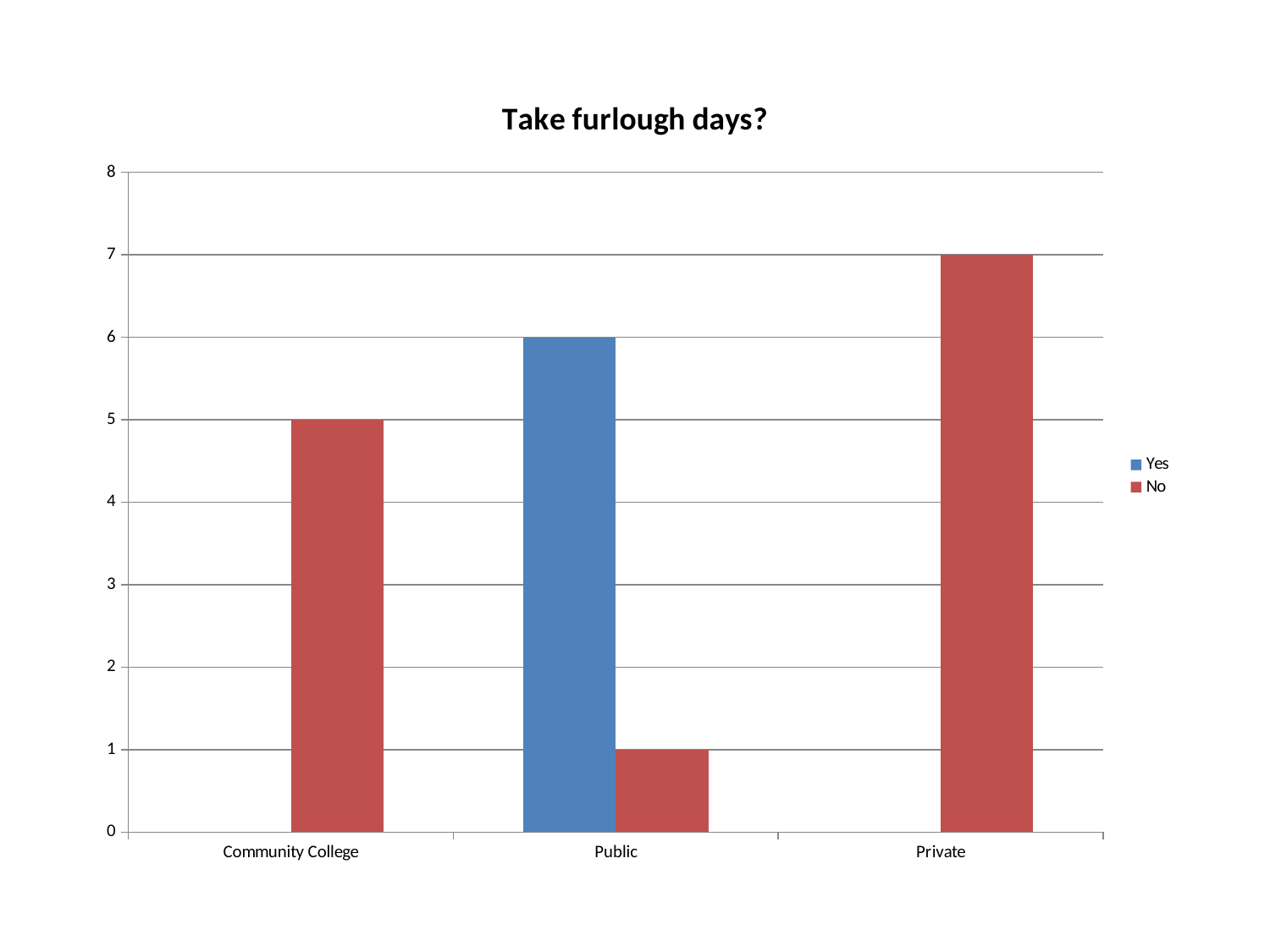
How many series does the legend list? 2 How many categories are shown on the x axis? 3 What is the value of Yes for Public? 6 What is the difference between the No value for Private and the No value for Community College? 2 What is the value of No for Private? 7 What kind of chart is shown on the slide? bar chart What is the title of the chart? Take furlough days? Which is larger for Public: the Yes value or the No value? Yes What is the value of No for Community College? 5 Which category has the highest No value? Private What is the value of No for Public? 1 Which category has the lowest No value? Public